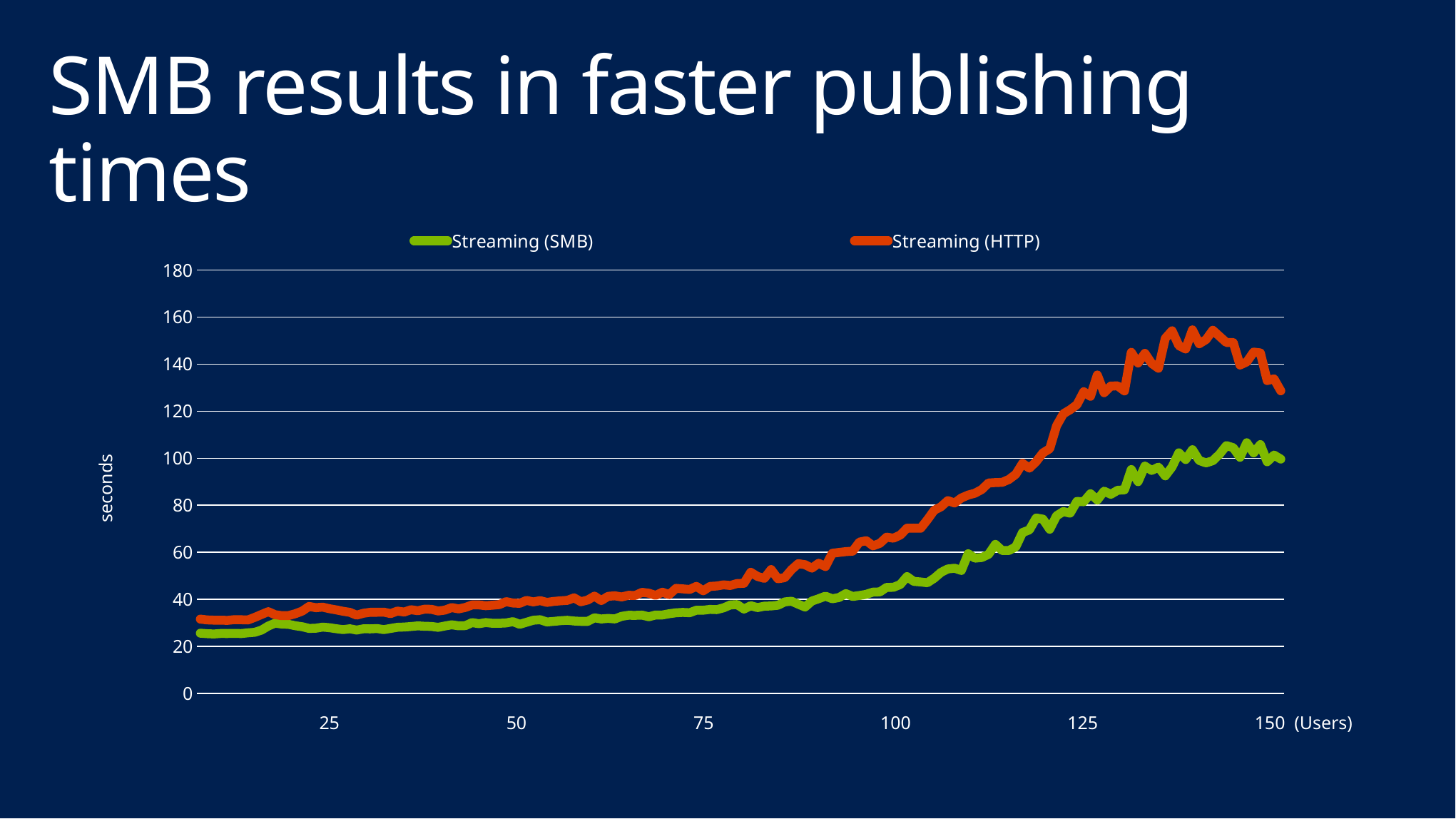
At 125 users, which series has the higher value, Streaming (SMB) or Streaming (HTTP)? Streaming (HTTP) Is the value for Streaming (HTTP) at 150 users greater or less than 120? greater Is the value for Streaming (SMB) at 125 users greater or less than 100? less How many series does the legend list? 2 Which series reaches the highest value on the chart? Streaming (HTTP) What is the label on the vertical axis? seconds Which series is drawn in green? Streaming (SMB) Is the value for Streaming (SMB) at 150 users greater or less than 120? less Does the Streaming (SMB) line generally rise or fall as the number of users increases? rise What kind of chart is shown on the slide? line chart